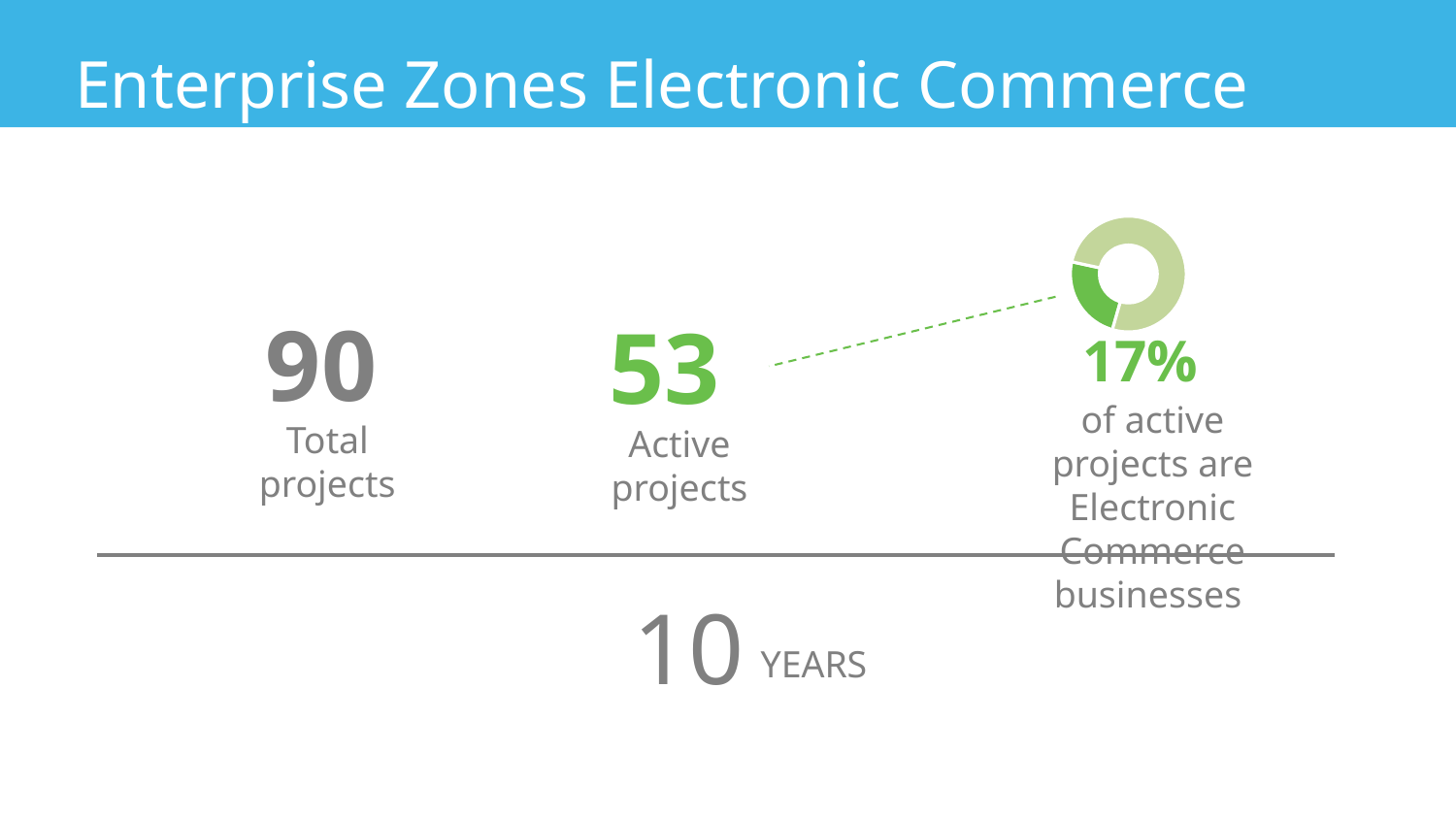
Which slice of the donut chart is the smallest? the dark green slice (17%) The 17% slice in the donut chart is a share of which group of projects? active projects Which slice of the donut chart is larger, the dark green slice or the light green slice? light green What percentage of active projects are Electronic Commerce businesses, according to the chart? 17% What kind of chart is shown on the slide? doughnut chart How many slices does the donut chart have? 2 What colour is the slice representing Electronic Commerce businesses in the donut chart? dark green